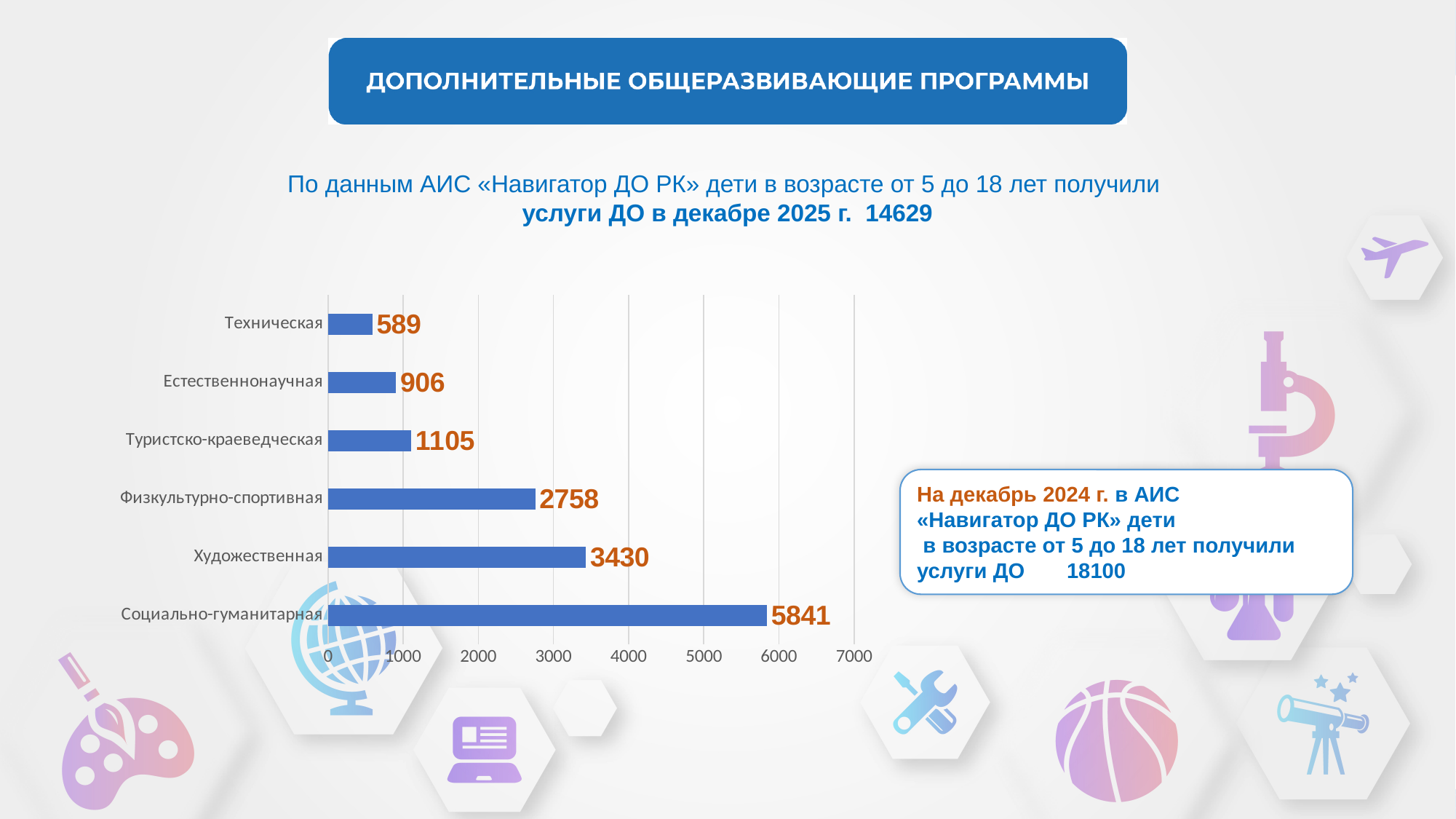
What is the value for Техническая? 589 What is the difference between the values for Туристско-краеведческая and Естественнонаучная? 199 Which category has the lowest value? Техническая Is the value for Художественная greater or less than 3000? greater What is the difference between the values for Художественная and Физкультурно-спортивная? 672 Which category has the highest value? Социально-гуманитарная What is the value for Социально-гуманитарная? 5841 How many categories are shown in the chart? 6 What is the value for Физкультурно-спортивная? 2758 What is the maximum value shown on the x axis of the chart? 7000 Which is larger, the value for Естественнонаучная or the value for Туристско-краеведческая? Туристско-краеведческая What kind of chart is shown on the slide? bar chart